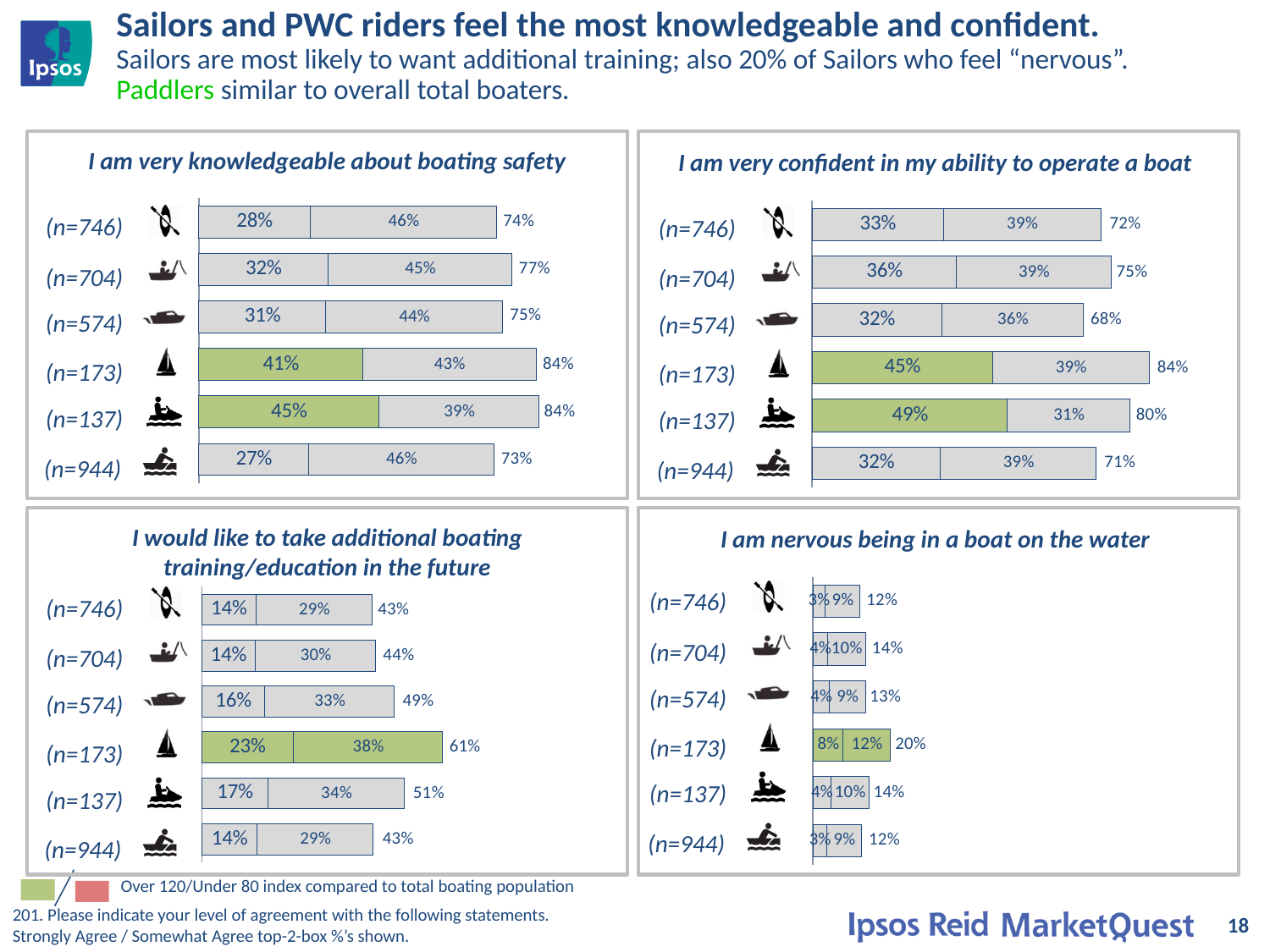
In the chart titled "I am very confident in my ability to operate a boat", which row has the lowest total value? (n=574) In the chart titled "I am very knowledgeable about boating safety", what is the strongly agree (first segment) value for the (n=137) row? 45% In the chart titled "I am nervous being in a boat on the water", what is the total value for the (n=173) row? 20% In the chart titled "I am very confident in my ability to operate a boat", what is the difference between the total values for the (n=137) row and the (n=944) row? 9% In the chart titled "I am very knowledgeable about boating safety", what is the total top-2-box value shown for the (n=704) row? 77% In the chart titled "I am very confident in my ability to operate a boat", what is the total value for the (n=173) row? 84% In the chart titled "I would like to take additional boating training/education in the future", what is the somewhat agree (second segment) value for the (n=574) row? 33% In the chart titled "I would like to take additional boating training/education in the future", which row has the highest total value? (n=173) How many rows (categories) are plotted in the chart titled "I am very knowledgeable about boating safety"? 6 In the chart titled "I would like to take additional boating training/education in the future", is the total value for the (n=137) row larger or smaller than the total for the (n=704) row? larger In the chart titled "I am nervous being in a boat on the water", what is the difference between the total values for the (n=173) row and the (n=746) row? 8% What kind of chart is used in the chart titled "I am nervous being in a boat on the water"? Stacked bar chart